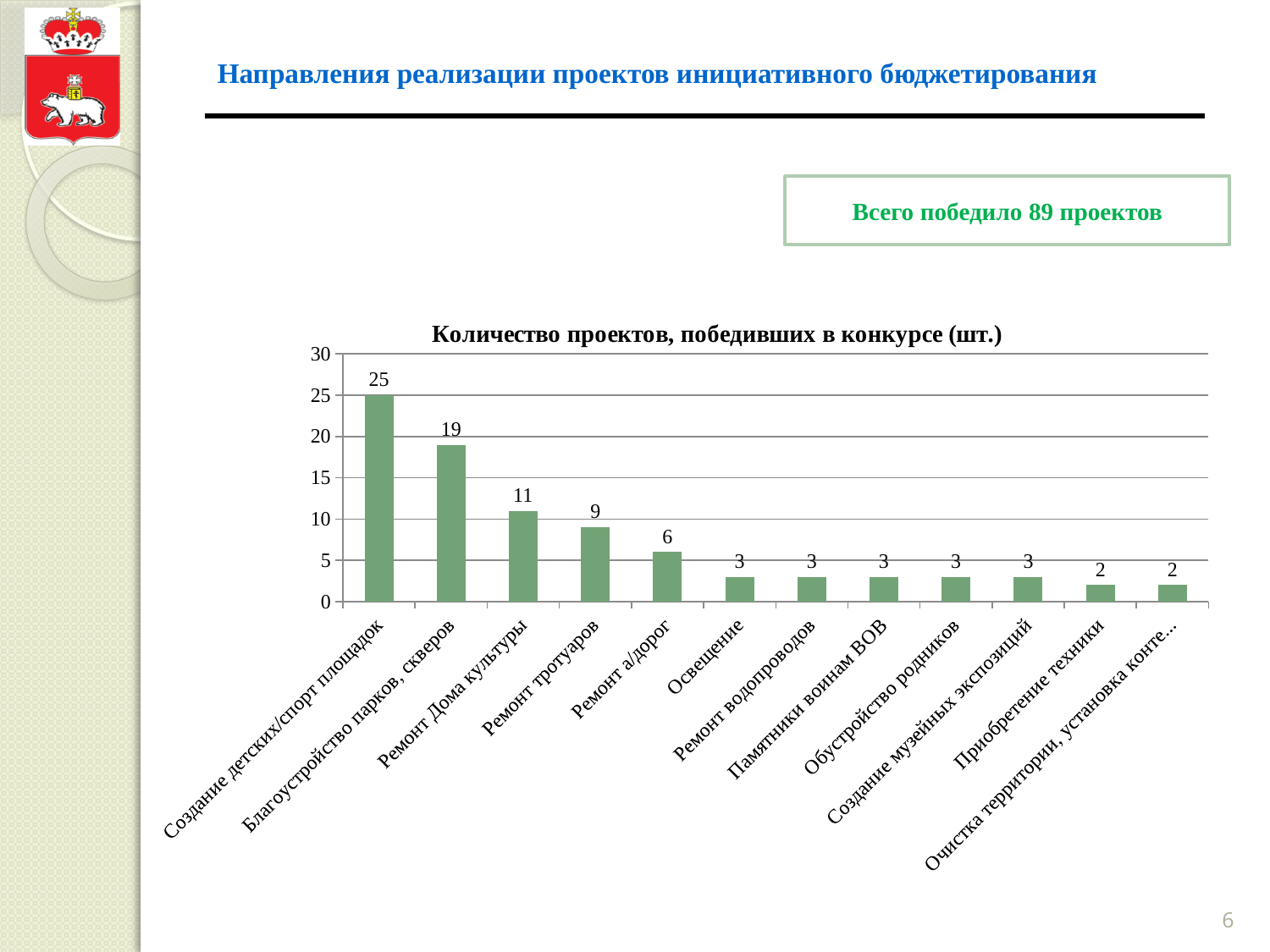
Which is larger, the value for Ремонт тротуаров or the value for Ремонт а/дорог? Ремонт тротуаров What is the title of the chart? Количество проектов, победивших в конкурсе (шт.) Which category has the highest value? Создание детских/спорт площадок What is the value for Создание детских/спорт площадок? 25 What is the value for Ремонт Дома культуры? 11 Is the value for Ремонт Дома культуры greater or less than 10? greater What is the value for Приобретение техники? 2 How many categories are shown on the chart? 12 What is the value for Благоустройство парков, скверов? 19 What kind of chart is shown on the slide? bar chart What is the value for Ремонт а/дорог? 6 What is the difference between the values for Создание детских/спорт площадок and Благоустройство парков, скверов? 6